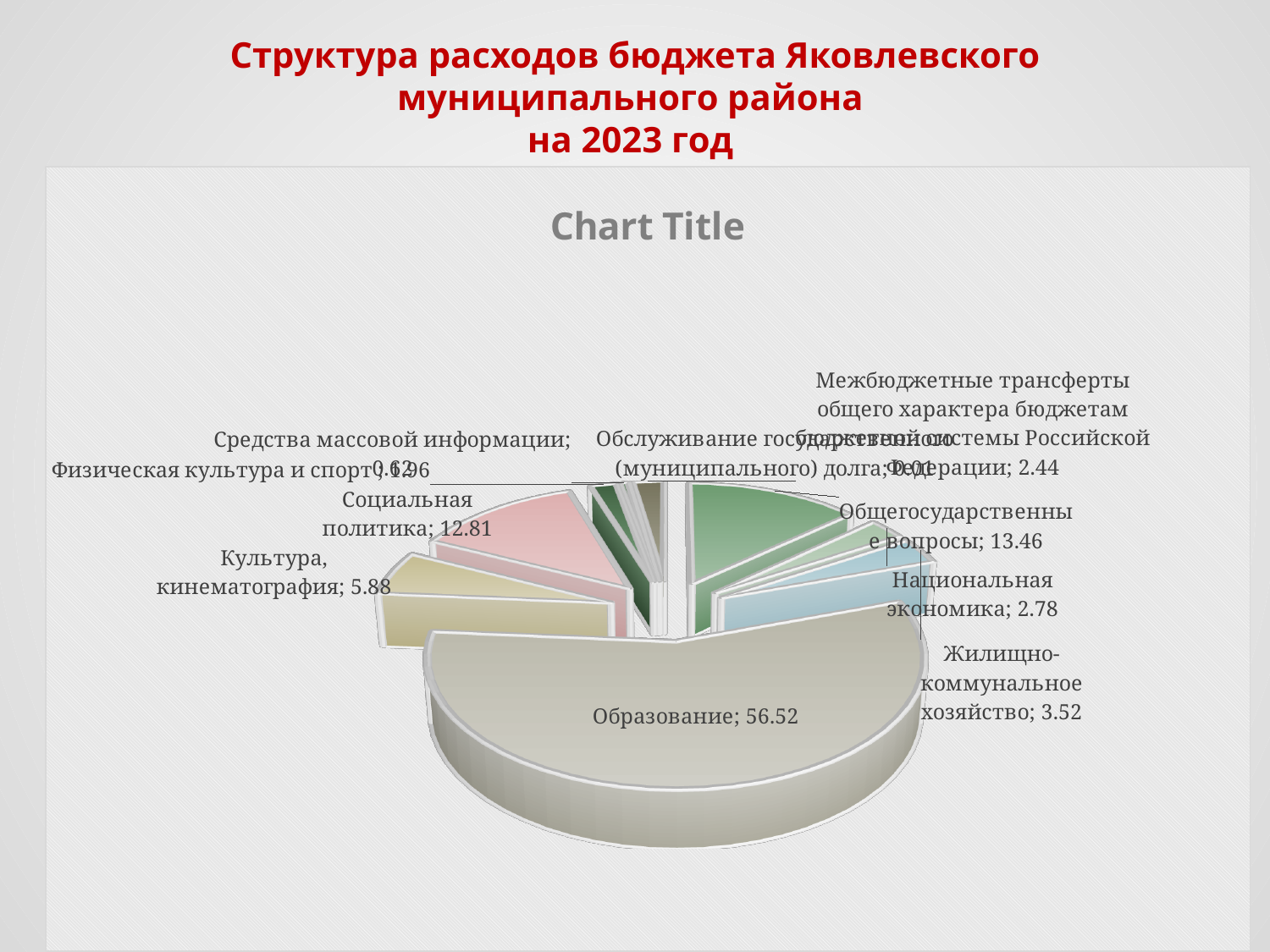
Which category has the largest slice of the pie? Образование Which is larger, Жилищно-коммунальное хозяйство or Национальная экономика? Жилищно-коммунальное хозяйство What is the value for Национальная экономика? 2.78 What is the value for Образование? 56.52 What title is printed above the pie chart? Chart Title What is the value for Жилищно-коммунальное хозяйство? 3.52 What is the value for Культура, кинематография? 5.88 What is the difference between the values for Образование and Общегосударственные вопросы? 43.06 What kind of chart is shown on the slide? pie chart Which is larger, Социальная политика or Общегосударственные вопросы? Общегосударственные вопросы What is the value for Общегосударственные вопросы? 13.46 What is the value for Социальная политика? 12.81